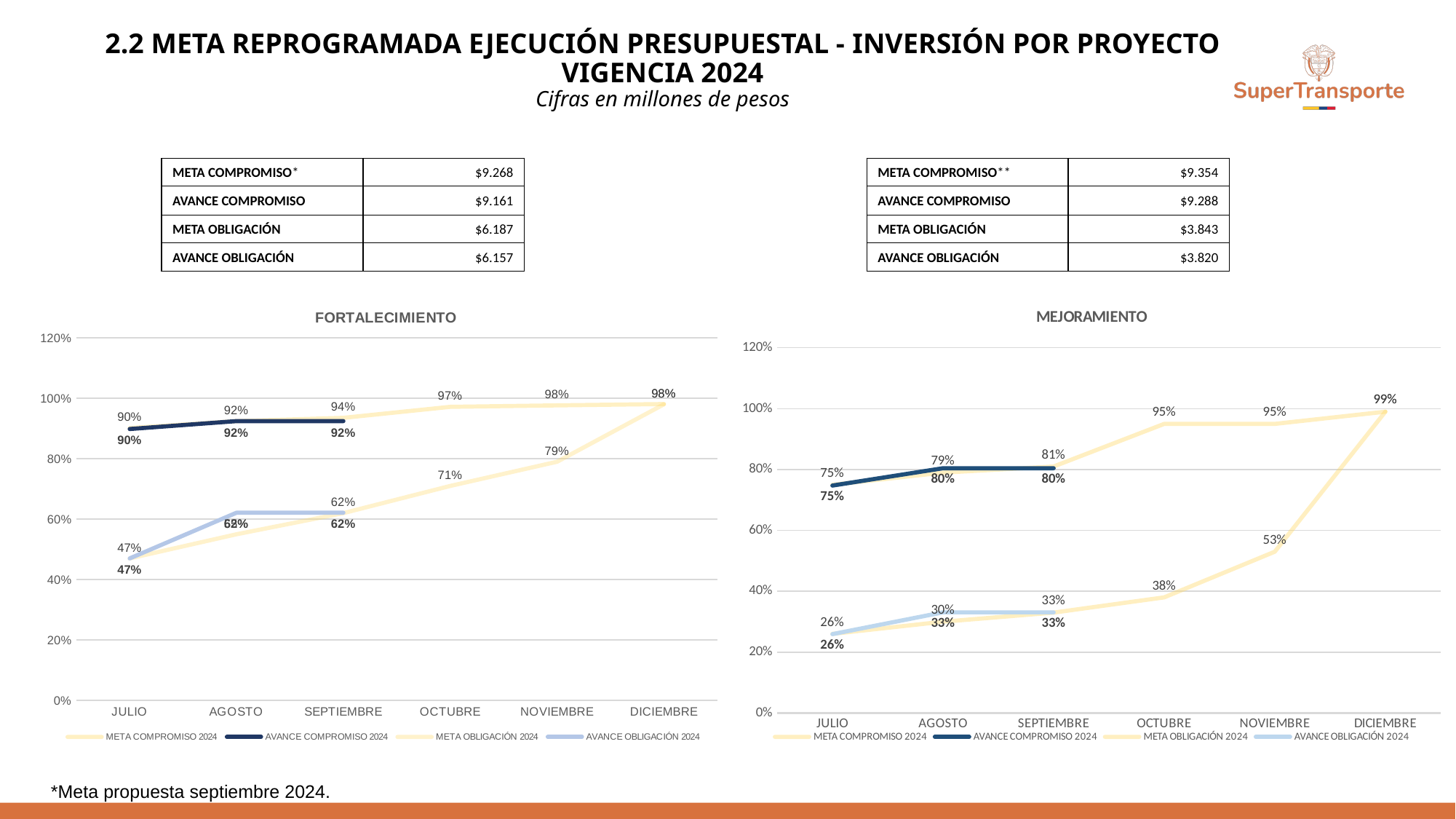
In the MEJORAMIENTO chart, what is the AVANCE COMPROMISO 2024 value for SEPTIEMBRE? 80% Does the META OBLIGACIÓN 2024 line in the MEJORAMIENTO chart rise or fall from JULIO to DICIEMBRE? rise In the MEJORAMIENTO chart, what is the META COMPROMISO 2024 value for OCTUBRE? 95% In the FORTALECIMIENTO chart, what is the META OBLIGACIÓN 2024 value for NOVIEMBRE? 79% In the MEJORAMIENTO chart, what is the META OBLIGACIÓN 2024 value for NOVIEMBRE? 53% How many months are shown on the x axis of the FORTALECIMIENTO chart? 6 What type of chart is the FORTALECIMIENTO chart? line chart In the FORTALECIMIENTO chart, what is the difference between the META OBLIGACIÓN 2024 values for DICIEMBRE and OCTUBRE? 27% How many series does the legend of the MEJORAMIENTO chart list? 4 In the MEJORAMIENTO chart, which month has the lowest META OBLIGACIÓN 2024 value? JULIO In the FORTALECIMIENTO chart, what is the AVANCE OBLIGACIÓN 2024 value for JULIO? 47% In the FORTALECIMIENTO chart, what is the META COMPROMISO 2024 value for DICIEMBRE? 98%